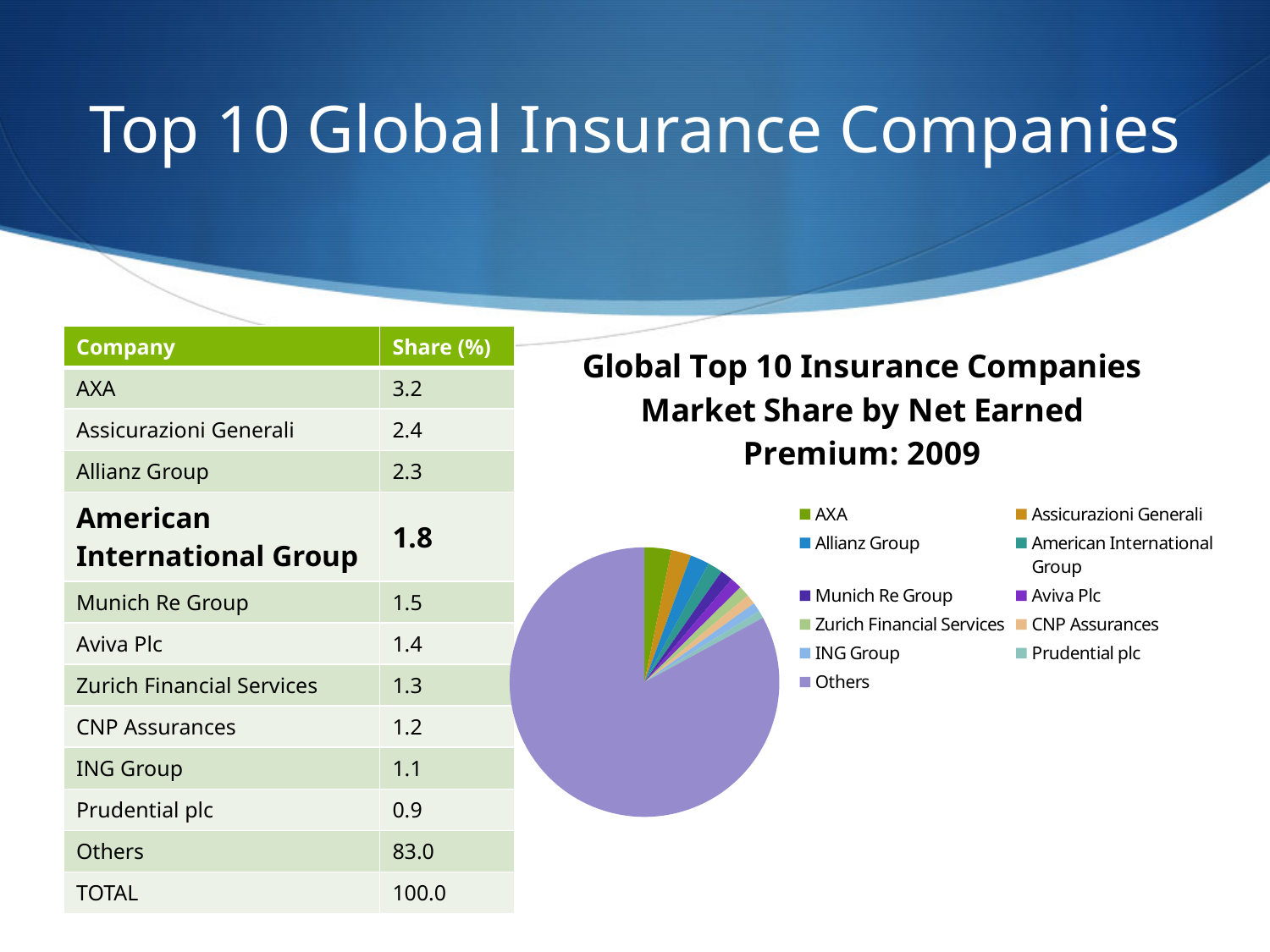
What is the title of the pie chart? Global Top 10 Insurance Companies Market Share by Net Earned Premium: 2009 Which category has the largest slice in the pie chart? Others What is the TOTAL share (%) shown on the slide? 100.0 Is the share for Others in the pie chart greater or less than 50%? greater What colour is the Others slice in the pie chart? purple What share (%) does the slide give for AXA? 3.2 Which of the named insurance companies has the smallest share (%) on the slide? Prudential plc What share (%) does the slide give for Others? 83.0 What kind of chart is shown on the slide? pie chart What is the difference in share (%) between AXA and Prudential plc? 2.3 Which of the two slices is larger in the pie chart, Others or AXA? Others How many entries does the pie chart's legend list? 11